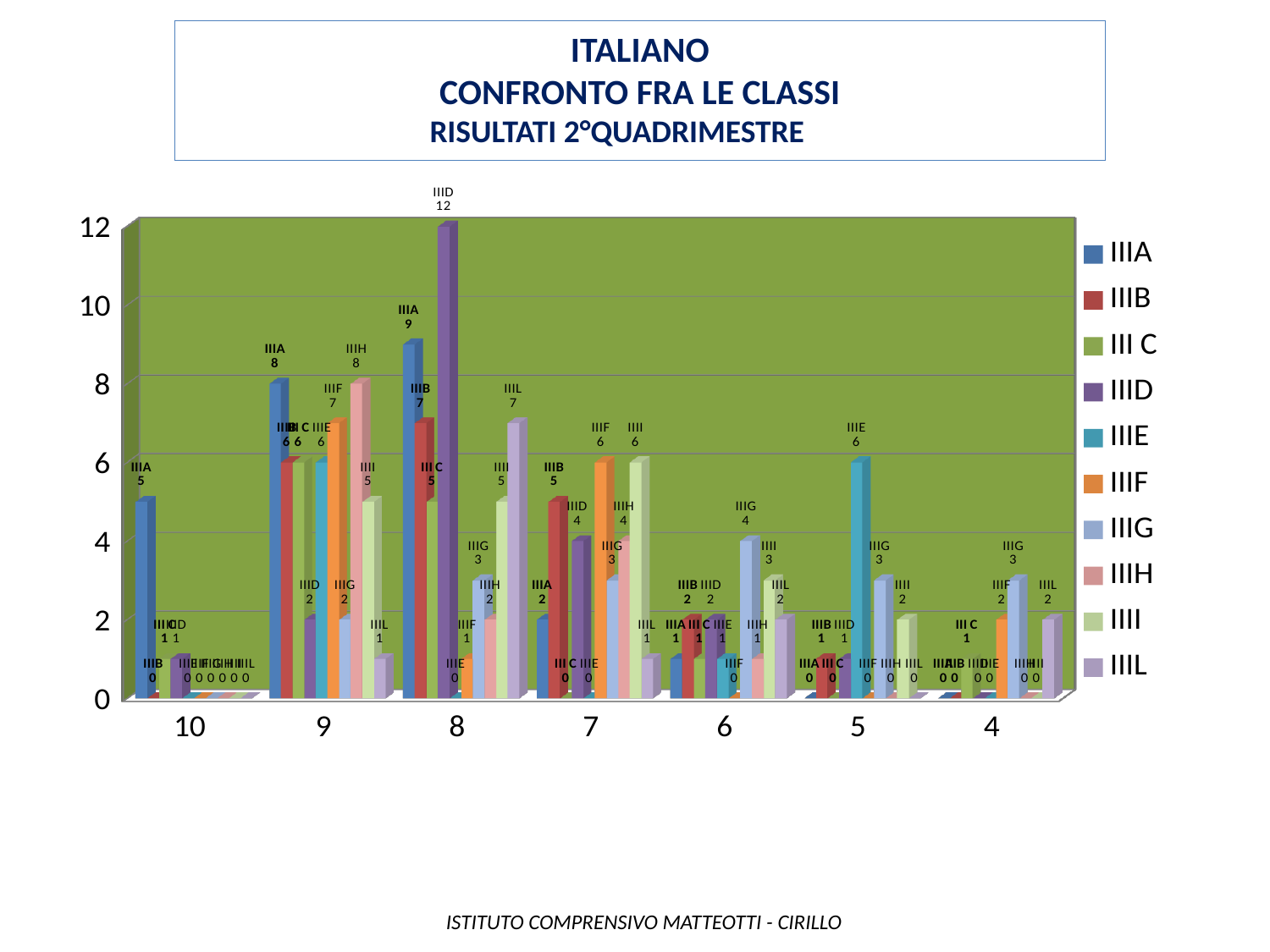
What is the title of the chart? ITALIANO CONFRONTO FRA LE CLASSI RISULTATI 2°QUADRIMESTRE What is the difference between the values of IIIA and IIIB at grade 8? 2 What is the value for class IIIE at grade 5? 6 What is the value for class IIIA at grade 9? 8 What is the value for class IIID at grade 8? 12 Which class has the highest value at grade 9? IIIA and IIIH (both 8) What kind of chart is shown on the slide? Bar chart How many grade categories are shown on the x axis? 7 At grade 9, which is larger: the value for IIIF or the value for IIIH? IIIH How many series does the legend list? 10 Which class has the highest bar in the whole chart, and at which grade? IIID at grade 8 What is the value for class IIIG at grade 4? 3